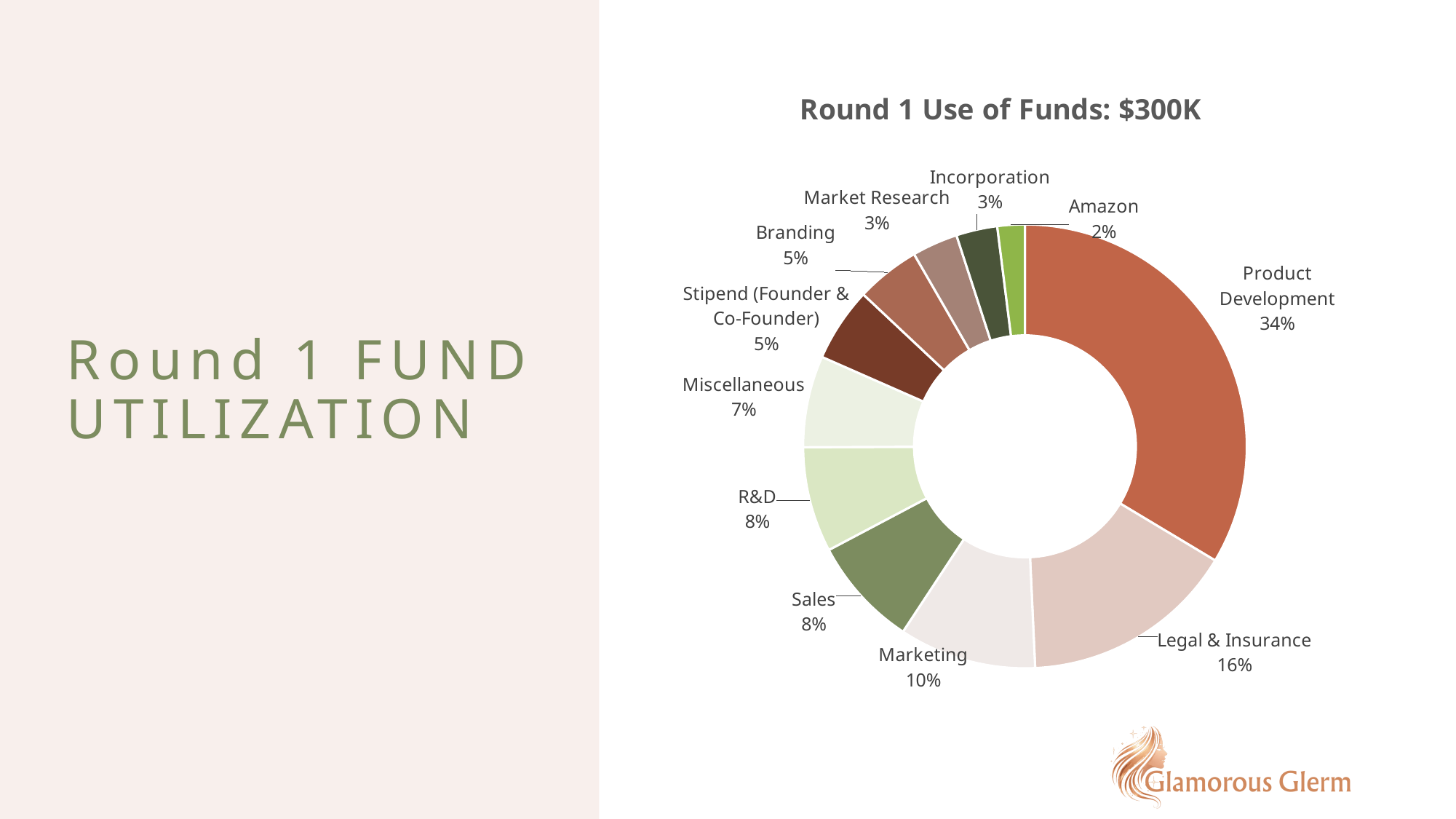
What kind of chart is shown on the slide? Doughnut chart What is the title of the chart? Round 1 Use of Funds: $300K How many categories are shown in the chart? 11 Which receives a larger share, Miscellaneous or Marketing? Marketing What share of Round 1 funds goes to Product Development? 34% What percentage of the funds is allocated to Legal & Insurance? 16% What is the combined share of Sales and R&D? 16% Which category receives the smallest share of the funds? Amazon What share is allocated to Marketing? 10% Which category receives the largest share of the funds? Product Development What is the difference in percentage points between Product Development and Legal & Insurance? 18 What percentage goes to Stipend (Founder & Co-Founder)? 5%